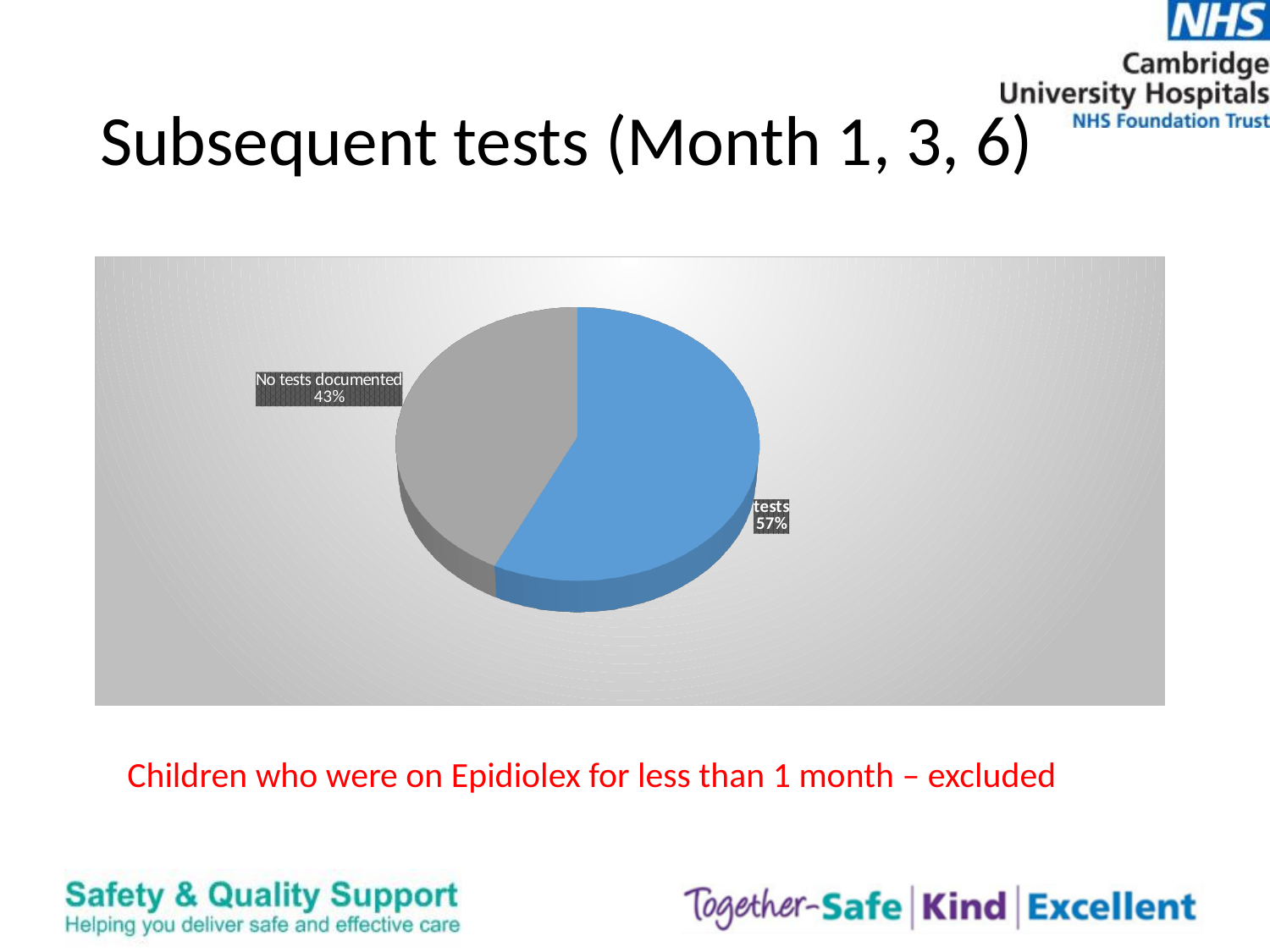
What is the title of the slide containing the pie chart? Subsequent tests (Month 1, 3, 6) What percentage is shown on the largest slice of the pie chart? 57% What kind of chart is shown on the slide? pie chart Is the "No tests documented" slice larger or smaller than the blue slice? smaller What colour is the "No tests documented" slice? grey Which slice of the pie chart is the smallest? No tests documented What percentage of the pie is labelled "No tests documented"? 43% How many slices does the pie chart have? 2 What is the difference in percentage points between the blue slice (57%) and the "No tests documented" slice (43%)? 14 Is the share for "No tests documented" greater or less than 50%? less What do the two slices of the pie chart add up to? 100% What share of the pie does the blue slice represent? 57%